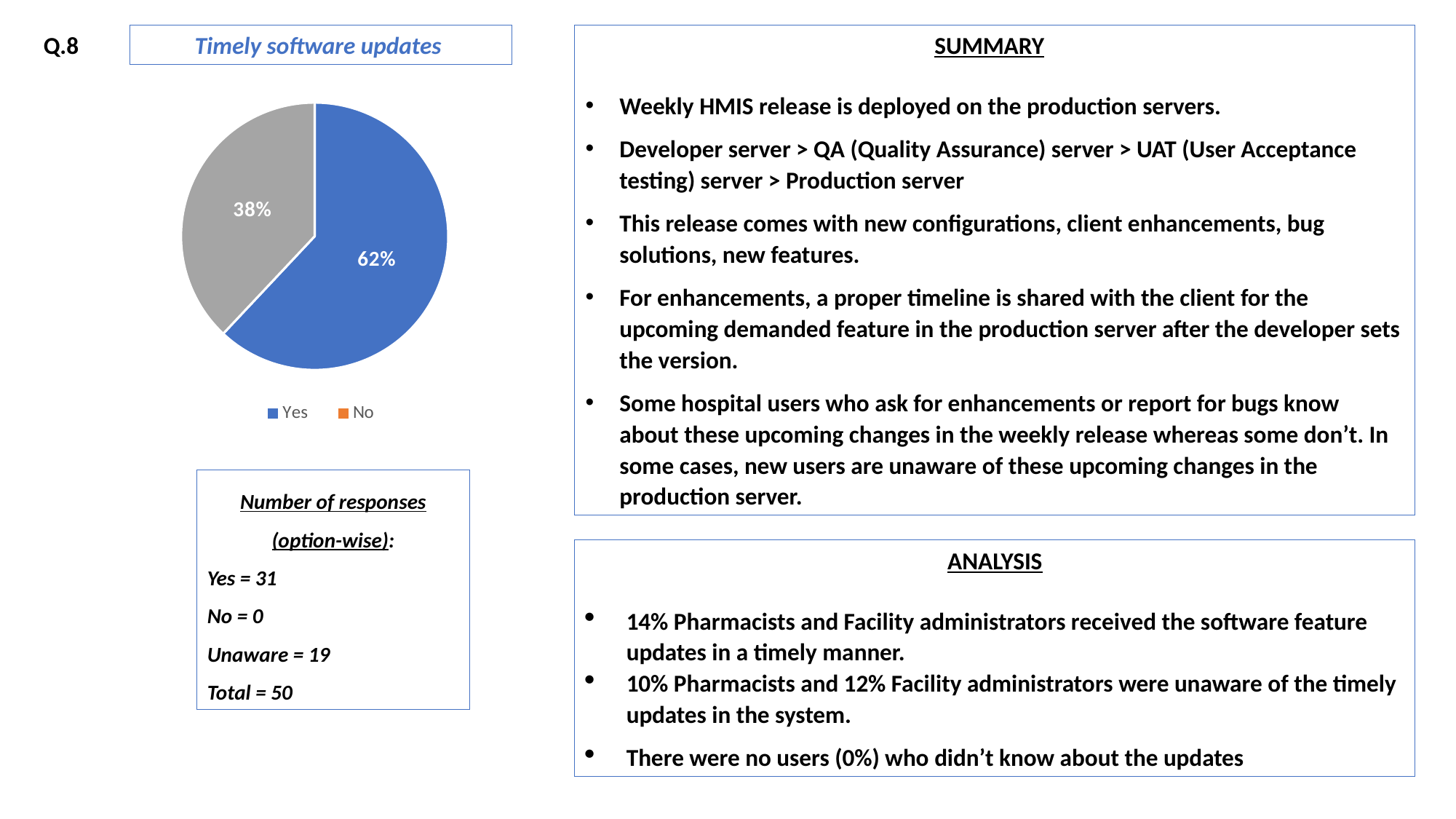
How many entries does the chart legend list? 2 What is the difference in percentage points between the two slices shown on the pie chart? 24% What kind of chart is shown on the slide? pie chart What percentage does the grey slice of the pie chart show? 38% Which slice of the pie chart is the largest? Yes Is the Yes slice of the pie chart larger or smaller than the grey slice? larger What colour is the Yes slice in the pie chart? blue Is the value for the Yes slice greater or less than 50%? greater What percentage does the Yes slice of the pie chart show? 62% How many slices are visible in the pie chart? 2 What is the title of the chart? Timely software updates